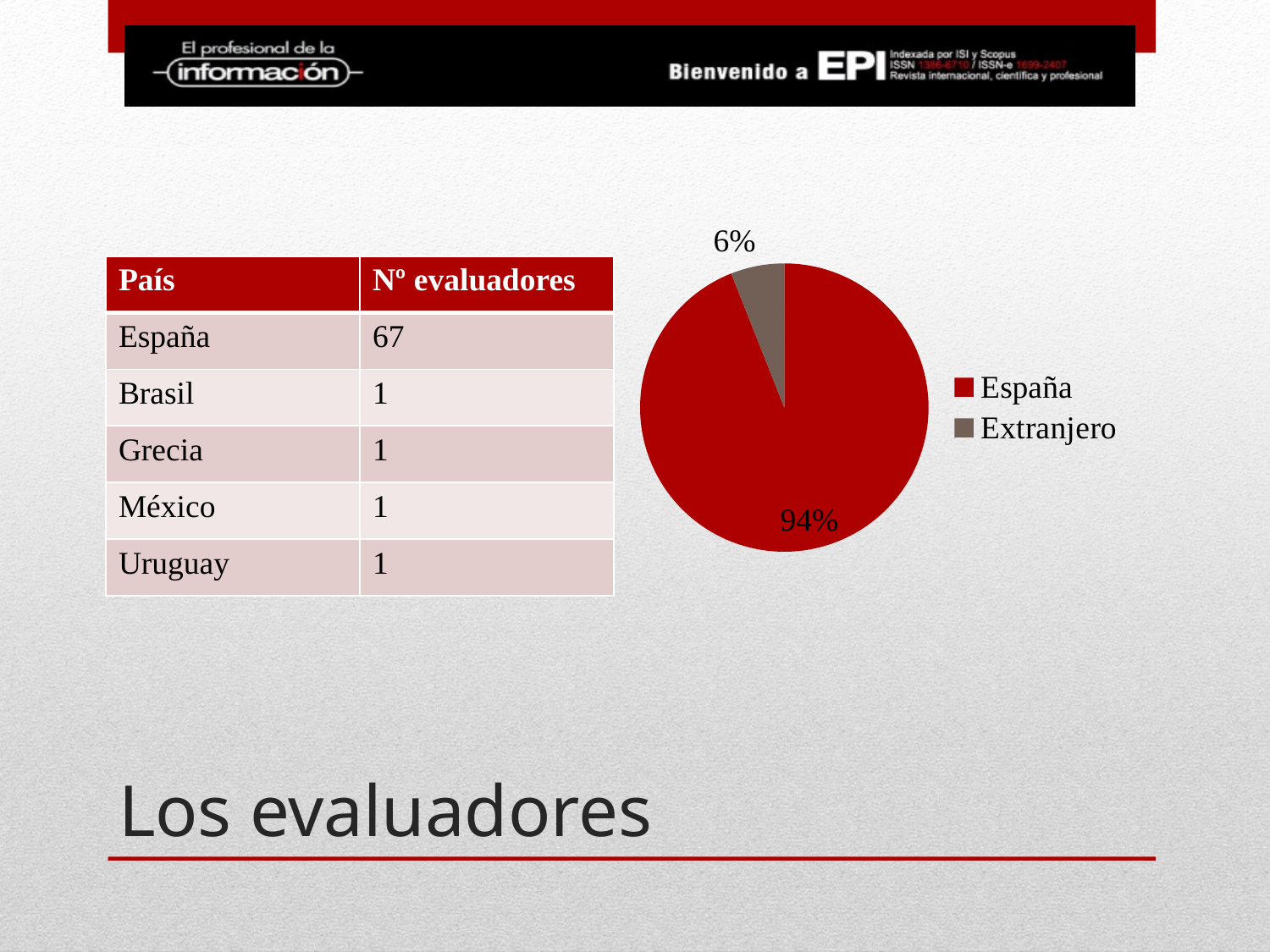
What kind of chart is shown on the slide? pie chart Which slice of the pie chart is the largest? España How many entries does the pie chart's legend list? 2 What are the two legend entries of the pie chart? España and Extranjero Which is larger in the pie chart, España or Extranjero? España How many slices does the pie chart have? 2 What share of the pie chart does Extranjero represent? 6% Which slice of the pie chart is the smallest? Extranjero What is the difference in percentage points between the España and Extranjero slices? 88 What share of the pie chart does España represent? 94% What colour is the España slice in the pie chart? red